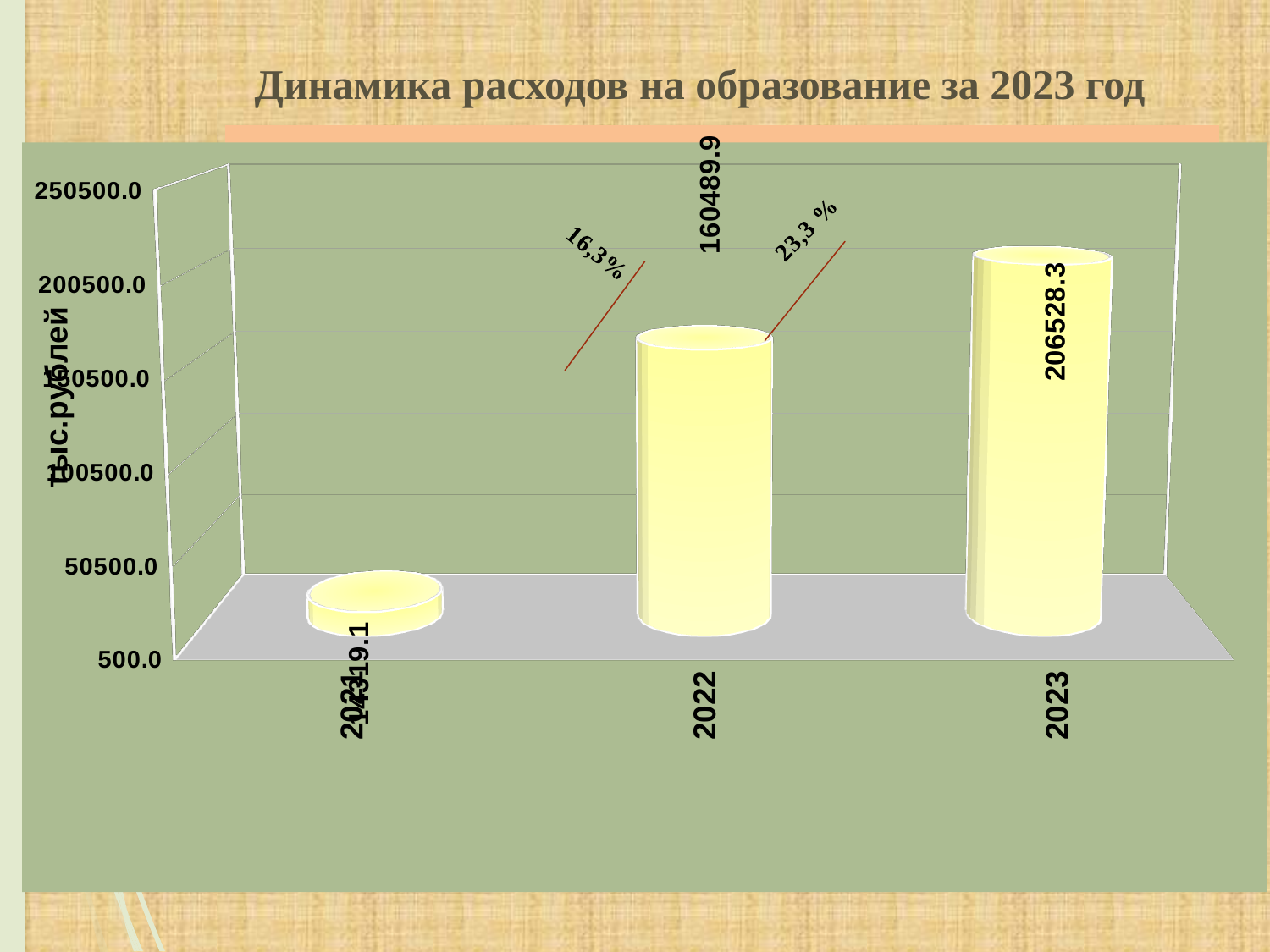
What is the value for 2022? 160489.9 What is the difference between the values for 2023 and 2022? 46038.4 Which year has the lowest value? 2021 What is the value for 2023? 206528.3 What kind of chart is shown on the slide? bar chart Is the value for 2022 greater or less than 150500.0? greater Which is larger, the value for 2022 or the value for 2023? 2023 Do the values rise or fall from 2021 to 2023? rise Is the value for 2021 greater or less than 50500.0? less Which year has the highest value? 2023 How many years are shown on the chart? 3 What is the title of the chart? Динамика расходов на образование за 2023 год